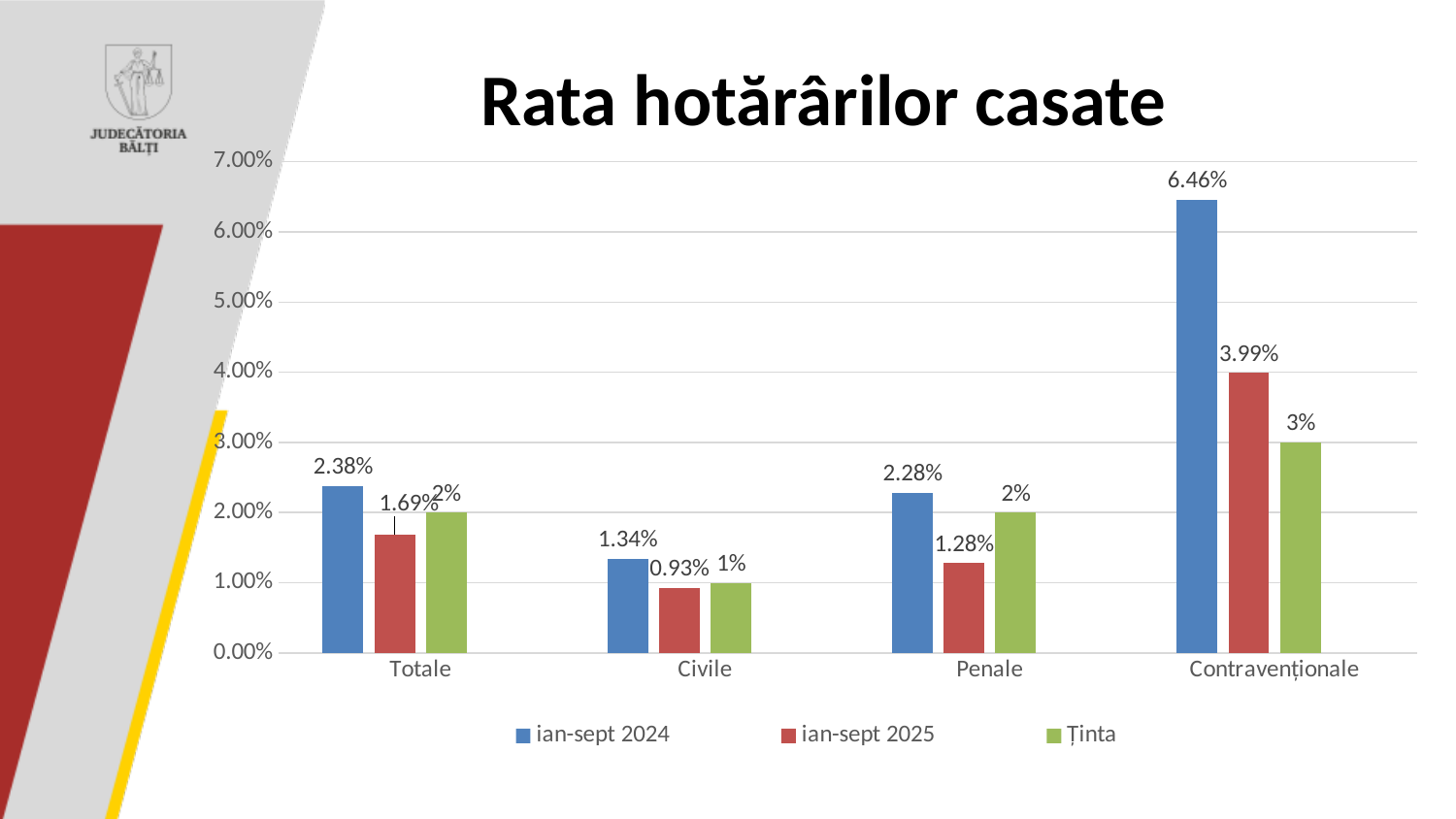
Which is larger for Penale: the ian-sept 2024 value or the ian-sept 2025 value? ian-sept 2024 What kind of chart is shown on the slide? bar chart Which category has the lowest value in the ian-sept 2025 series? Civile What is the Ținta value for Penale? 2% What is the value for Civile in the ian-sept 2025 series? 0.93% Which category has the highest value in the ian-sept 2024 series? Contravenționale How many categories are shown on the x axis? 4 What is the value for Totale in the ian-sept 2025 series? 1.69% What is the difference between the ian-sept 2024 and ian-sept 2025 values for Contravenționale? 2.47% What is the value for Contravenționale in the ian-sept 2024 series? 6.46% What is the title of the chart? Rata hotărârilor casate How many series does the legend list? 3